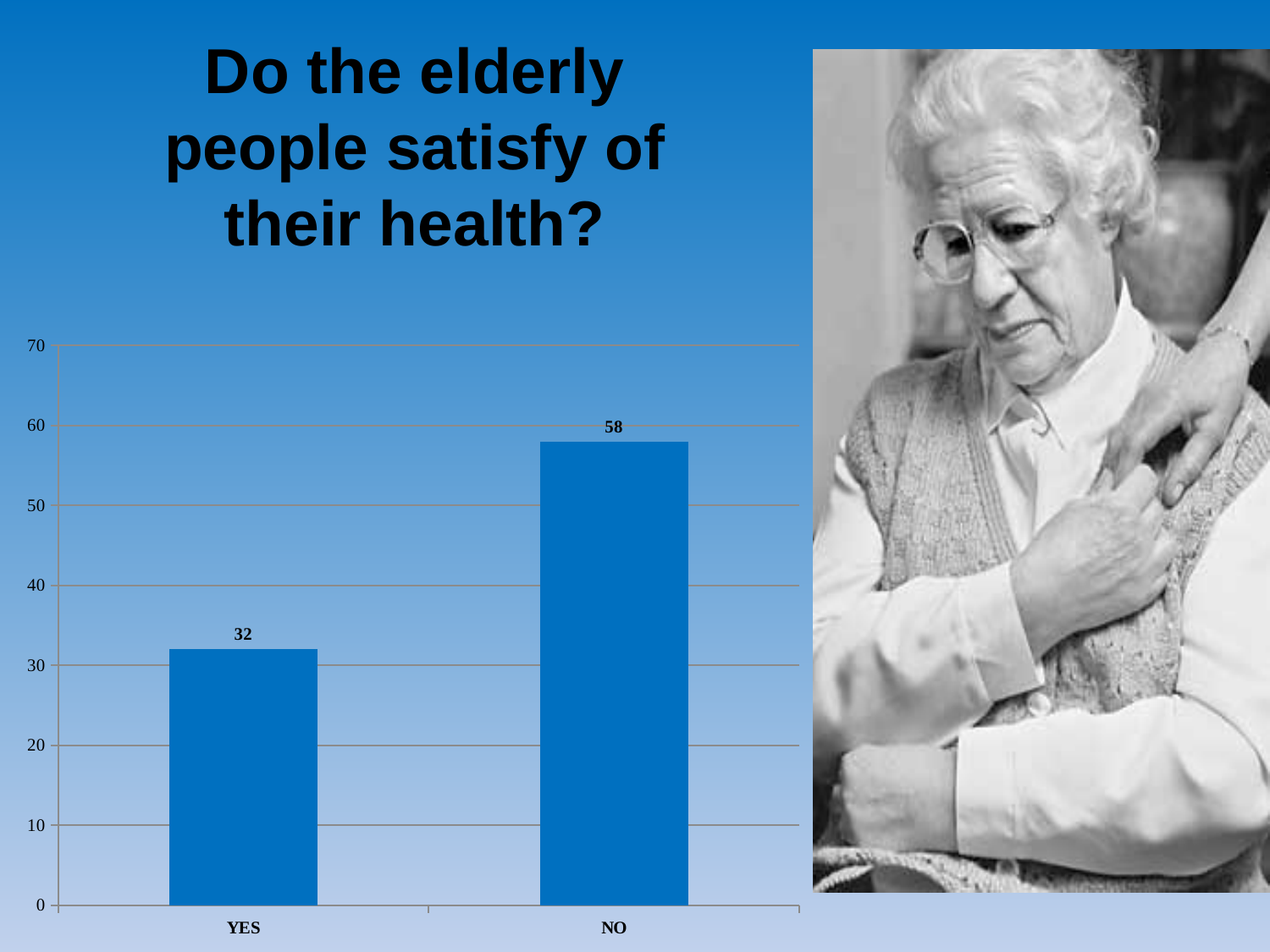
Which is larger, the value for YES or the value for NO? NO What is the title of the slide above the chart? Do the elderly people satisfy of their health? Is the value for NO greater or less than 50? greater What kind of chart is shown on the slide? bar chart Which category has the highest value? NO Is the value for YES greater or less than 40? less What is the difference between the values for NO and YES? 26 What is the value for YES? 32 How many categories are shown on the x axis? 2 What is the value for NO? 58 What is the highest value shown on the y axis? 70 Which category has the lowest value? YES